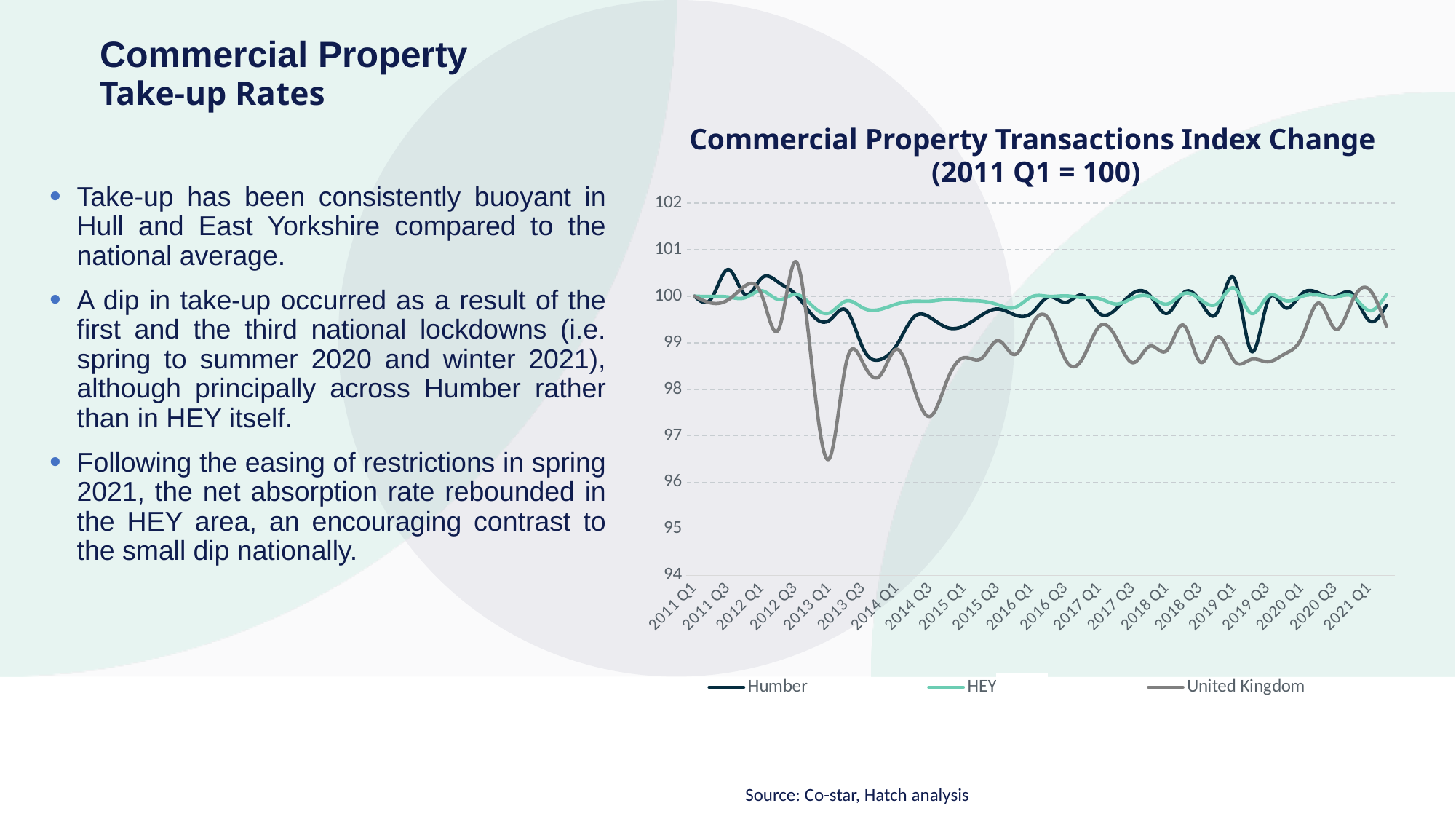
Which series has the lowest value around 2013 Q1? United Kingdom Is the United Kingdom value around 2014 Q3 greater or less than 98? less What are the three series named in the chart legend? Humber, HEY, United Kingdom How many series does the legend of the chart list? 3 What is the title of the chart? Commercial Property Transactions Index Change (2011 Q1 = 100) What is the last x-axis label on the chart? 2021 Q1 Around 2013 Q1, which series is higher, HEY or United Kingdom? HEY What is the first x-axis label on the chart? 2011 Q1 Is the United Kingdom value around 2013 Q1 greater or less than 97? less What kind of chart is shown on the slide? Line chart Does the United Kingdom line rise or fall between 2012 Q3 and 2013 Q1? Fall